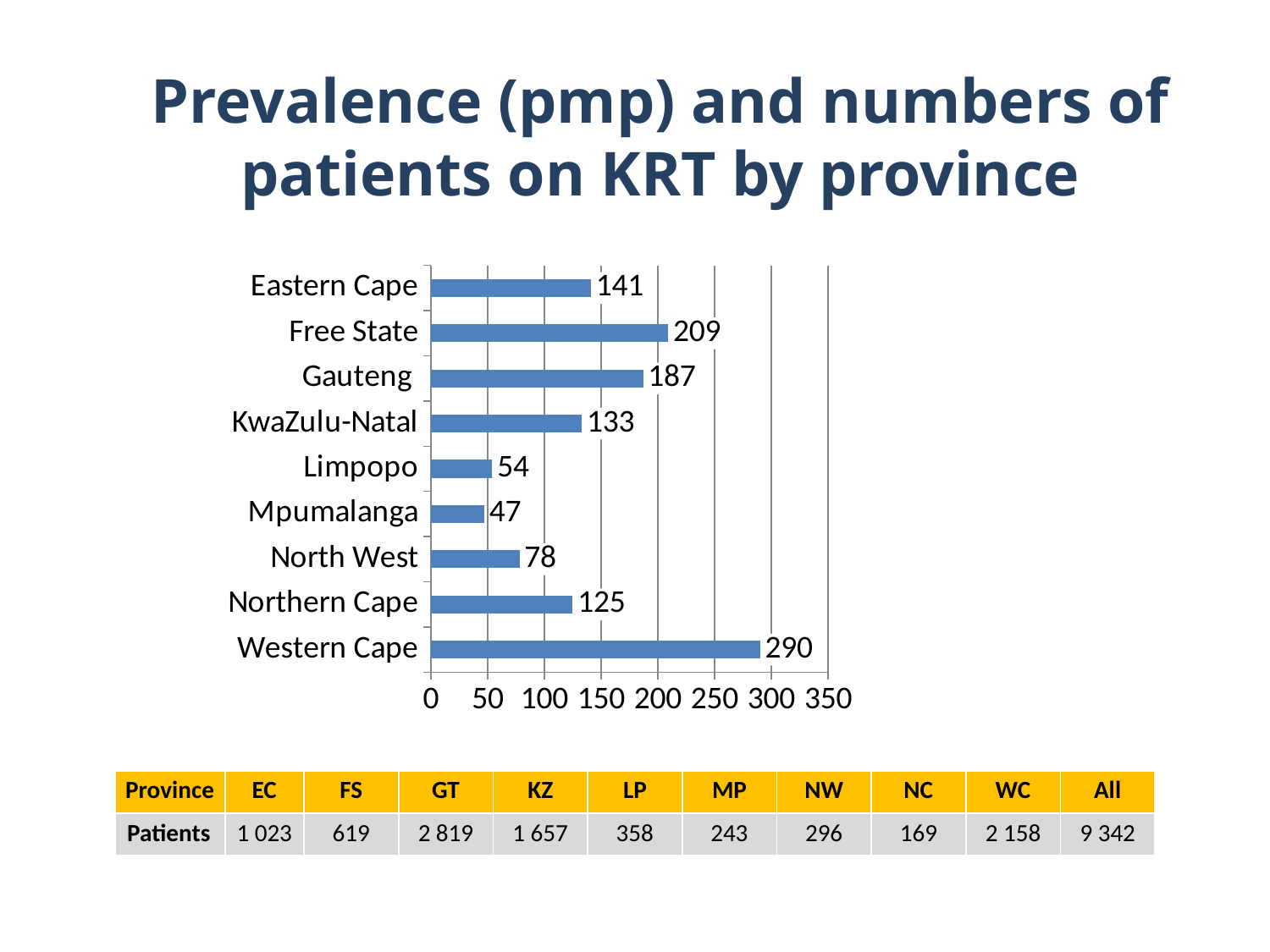
Which province has the lowest prevalence (pmp) in the chart? Mpumalanga What is the maximum value shown on the chart's horizontal axis? 350 What kind of chart is shown on the slide? bar chart What is the prevalence (pmp) value shown for Limpopo? 54 What is the difference between the prevalence values for Free State and Eastern Cape? 68 What is the difference between the prevalence values for Western Cape and Mpumalanga? 243 Which has a higher prevalence (pmp), KwaZulu-Natal or Northern Cape? KwaZulu-Natal What is the prevalence (pmp) value shown for Gauteng? 187 Which province has the highest prevalence (pmp) in the chart? Western Cape What is the prevalence (pmp) value shown for Western Cape? 290 How many provinces are shown in the chart? 9 Is the prevalence value for North West greater or less than 100? less